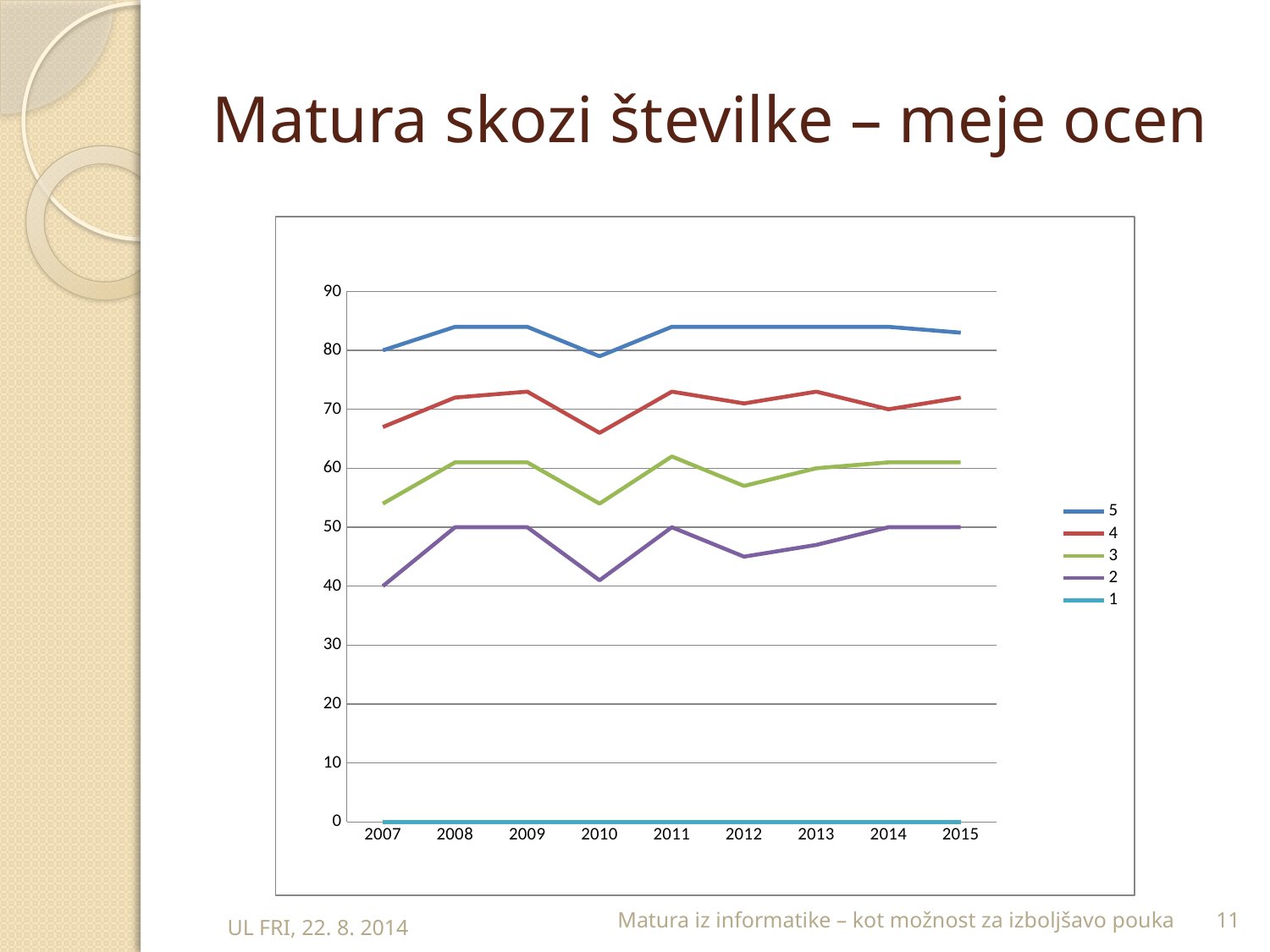
What kind of chart is shown on the slide? line chart Is the value of series 3 in 2007 greater or less than 60? less What is the value of series 2 in 2008? 50 Is the value of series 2 in 2012 greater or less than 50? less In which year is series 4 at its lowest? 2010 How many series does the legend list? 5 Is the value of series 4 in 2010 greater or less than 70? less Which series has the higher value in 2007, series 5 or series 4? 5 In which year is series 5 at its lowest? 2010 What is the value of series 1 in 2010? 0 How many years are shown on the x axis? 9